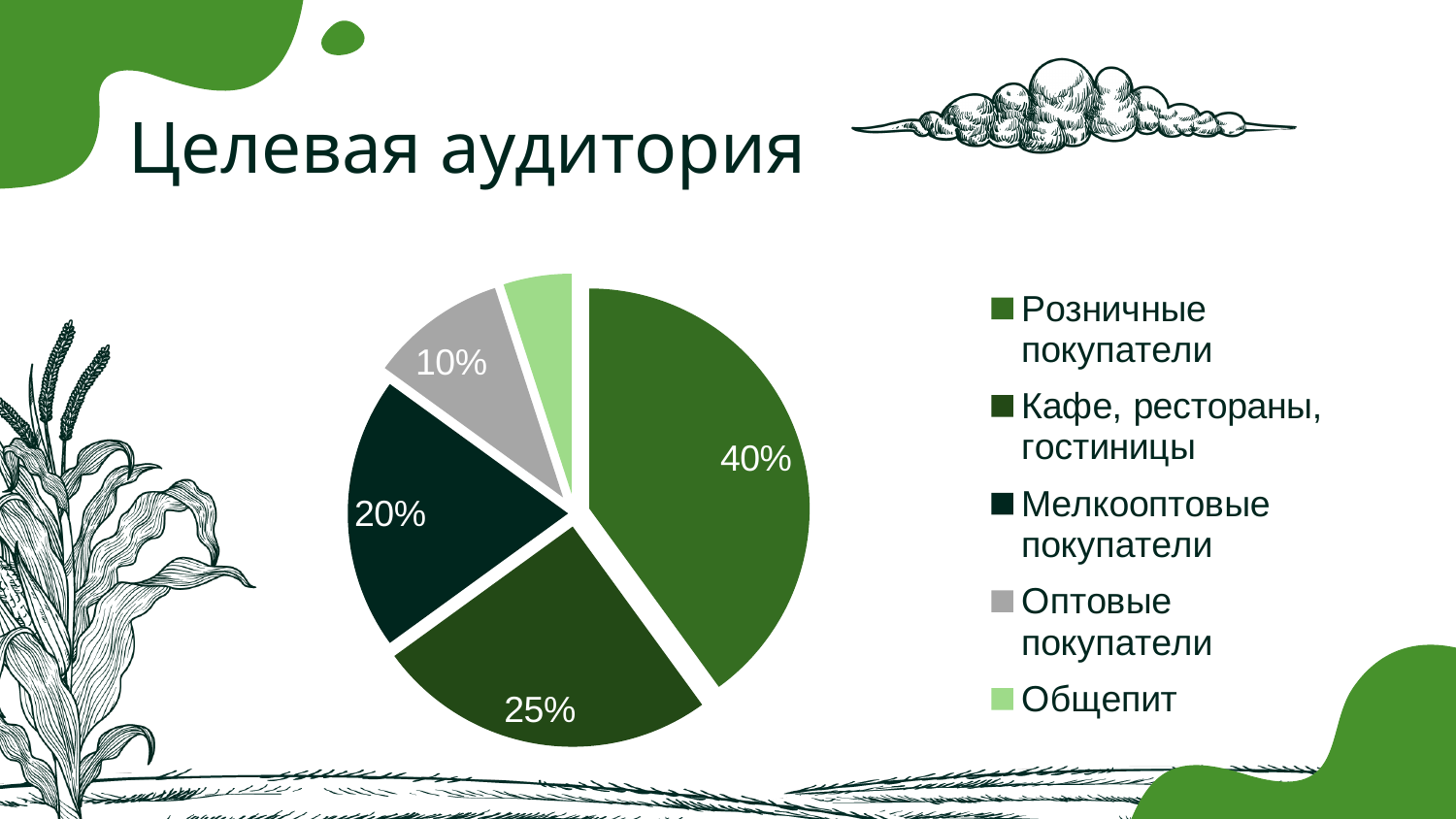
Which is larger: the share of Мелкооптовые покупатели or Оптовые покупатели? Мелкооптовые покупатели What is the title of the slide? Целевая аудитория Which category has the largest slice of the pie? Розничные покупатели What share of the pie does Розничные покупатели hold? 40% What is the difference between the shares of Розничные покупатели and Кафе, рестораны, гостиницы? 15% What is the value for Оптовые покупатели? 10% How many slices does the pie chart have? 5 Which category has the smallest slice of the pie? Общепит What percentage is labelled for Мелкооптовые покупатели? 20% What is the value shown for Кафе, рестораны, гостиницы? 25% What type of chart is shown on the slide? Pie chart How many entries does the legend list? 5